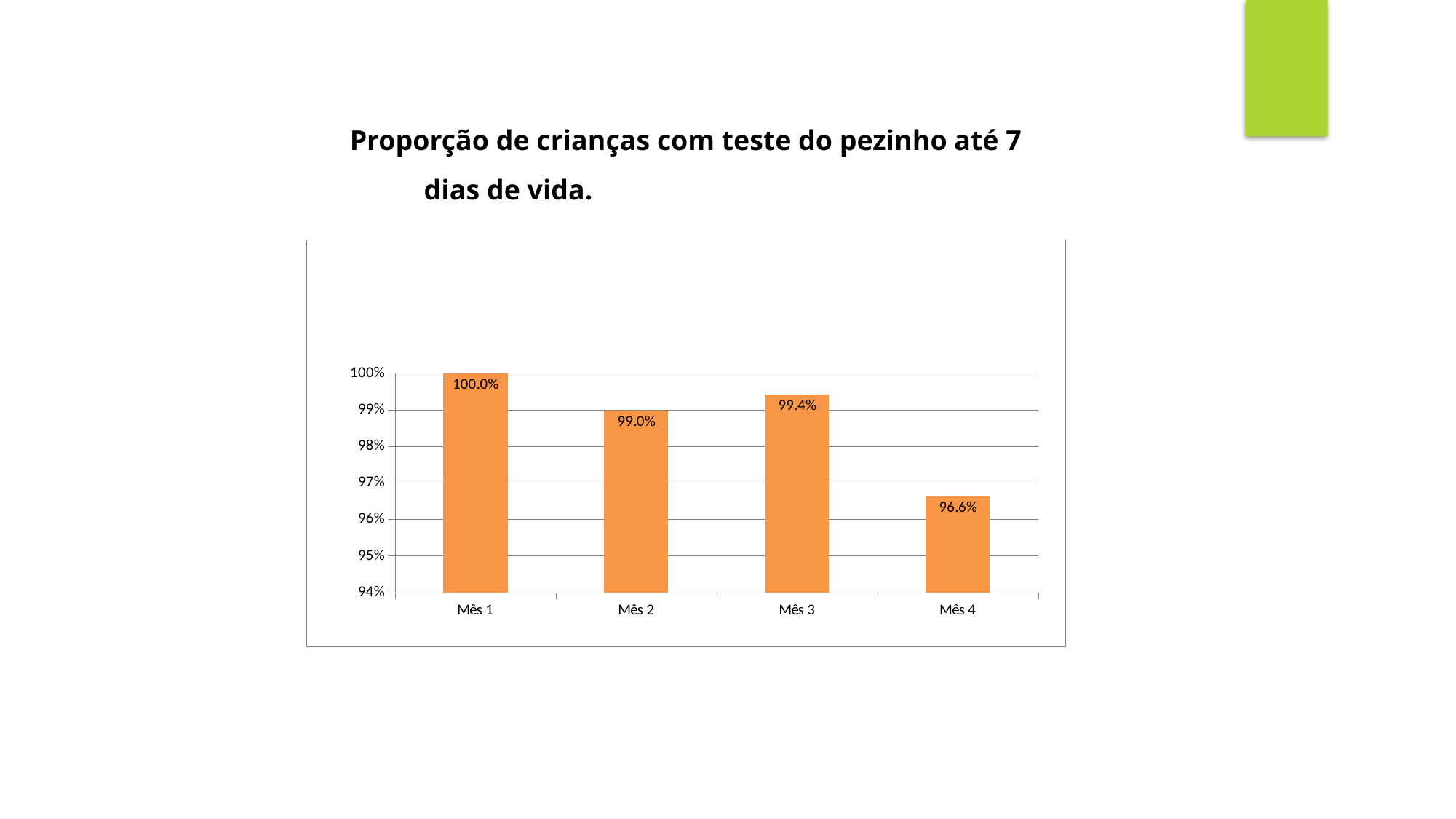
What is the title of the chart? Proporção de crianças com teste do pezinho até 7 dias de vida. How many months are shown on the x axis? 4 Which is larger, the value for Mês 2 or the value for Mês 4? Mês 2 What is the value for Mês 2? 99.0% What is the value for Mês 4? 96.6% What is the difference between the values for Mês 1 and Mês 4? 3.4% What kind of chart is shown on the slide? Bar chart Which month has the highest value? Mês 1 What is the difference between the values for Mês 3 and Mês 2? 0.4% What is the value for Mês 3? 99.4% What is the value for Mês 1? 100.0% Which month has the lowest value? Mês 4